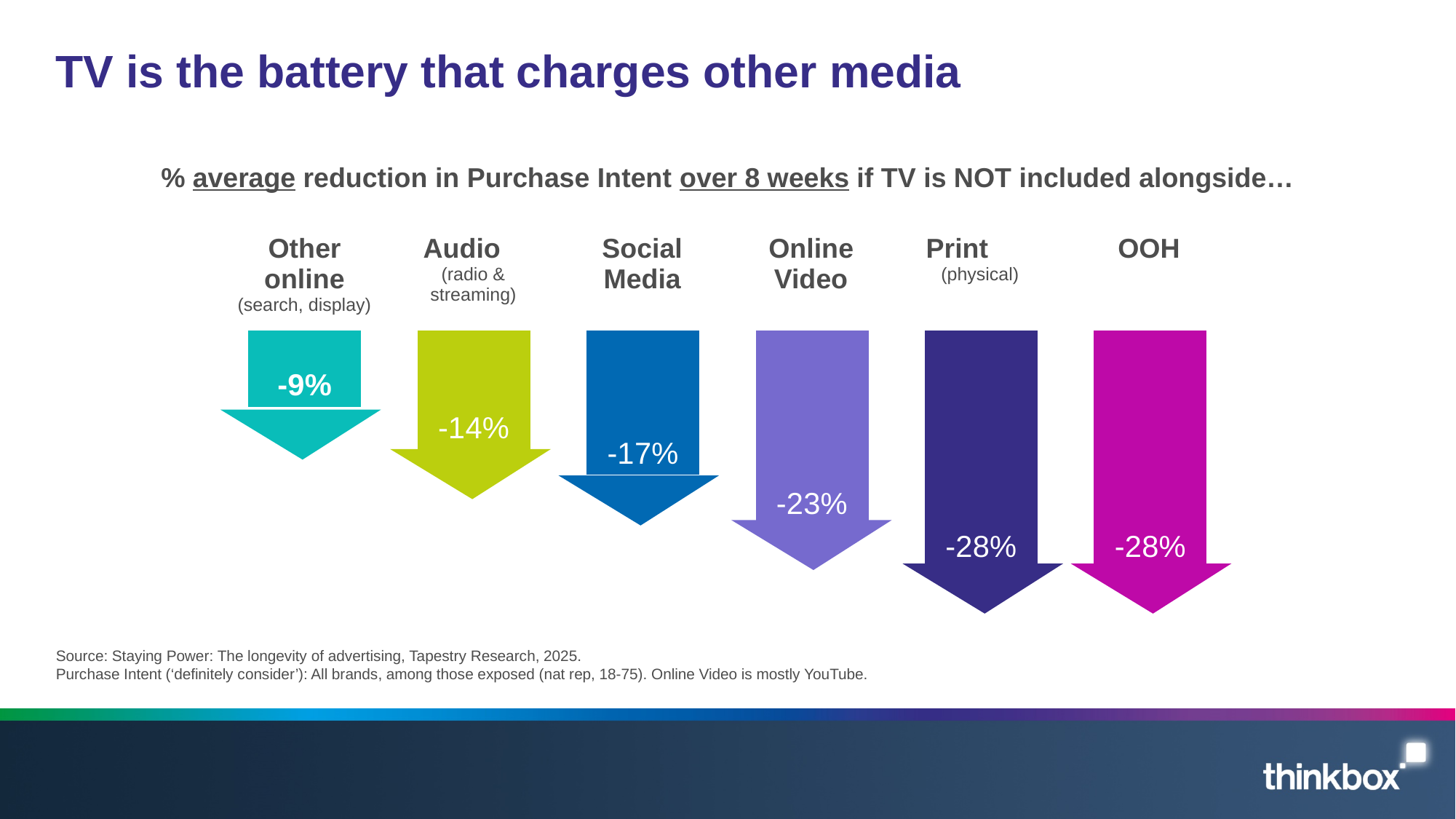
Do the reductions get larger or smaller moving from left to right across the chart? Larger What is the value shown for Audio (radio & streaming)? -14% What is the value shown for Print (physical)? -28% What is the title of the slide? TV is the battery that charges other media What is the difference between the values for Audio and Other online? 5 percentage points How many media categories are shown in the chart? 6 What is the value shown for Social Media? -17% What is the value shown for Other online (search, display)? -9% Which shows a larger reduction, Social Media or Audio? Social Media What is the difference between the values for Online Video and Social Media? 6 percentage points What is the value shown for Online Video? -23% Which category shows the smallest reduction in Purchase Intent? Other online (search, display)